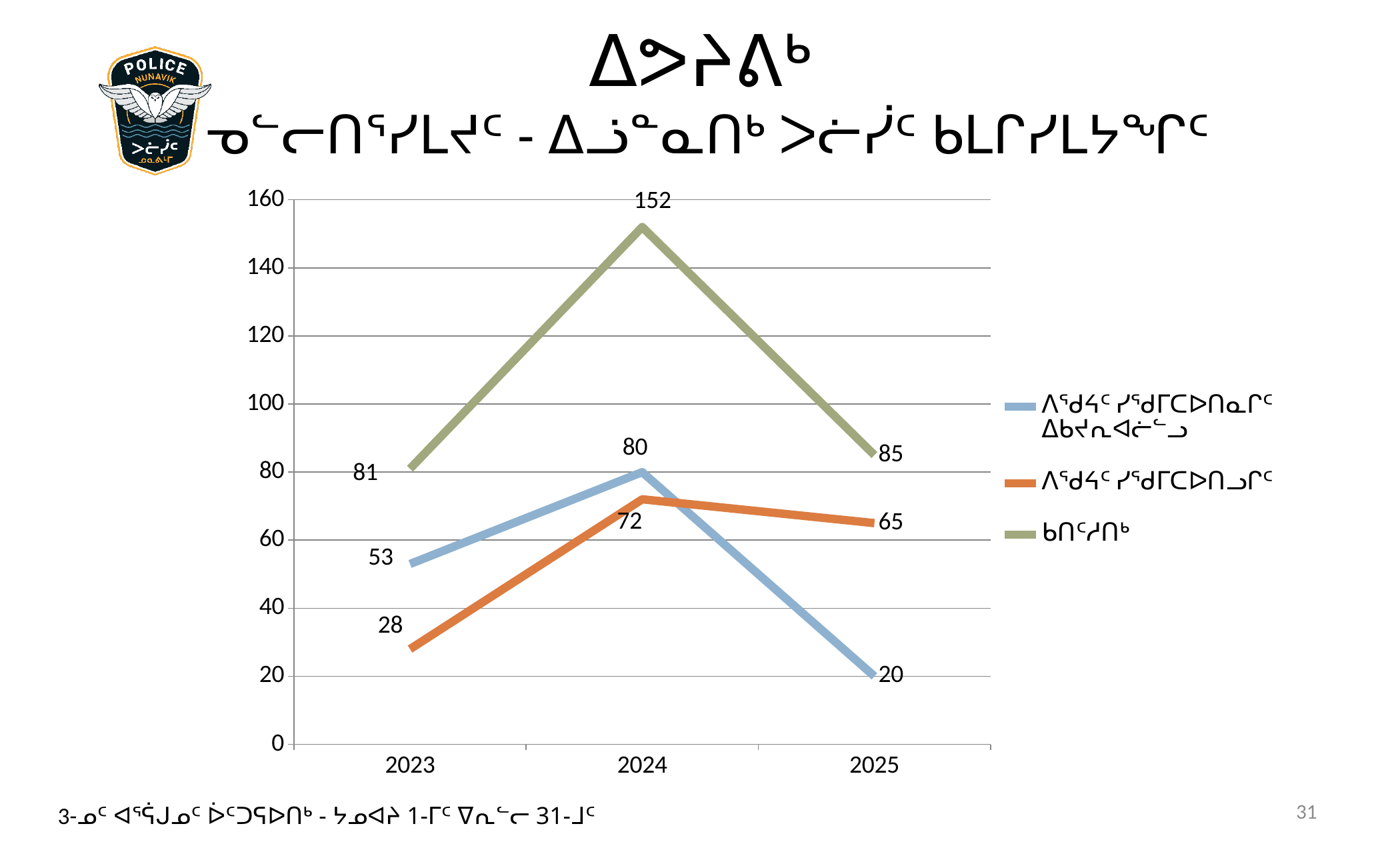
How many series does the chart's legend list? 3 What is the value of the blue line in 2025? 20 What is the value of the green line in 2024? 152 Does the orange line rise or fall from 2023 to 2024? rise By how much does the green line fall from 2024 to 2025? 67 What is the value of the orange line in 2023? 28 What kind of chart is shown on the slide? line chart How many years are shown on the x axis of the chart? 3 In 2023, which line has the larger value, the blue line or the orange line? the blue line In which year does the green line reach its highest value? 2024 In which year does the blue line have its lowest value? 2025 What is the difference between the blue line's values in 2024 and 2023? 27